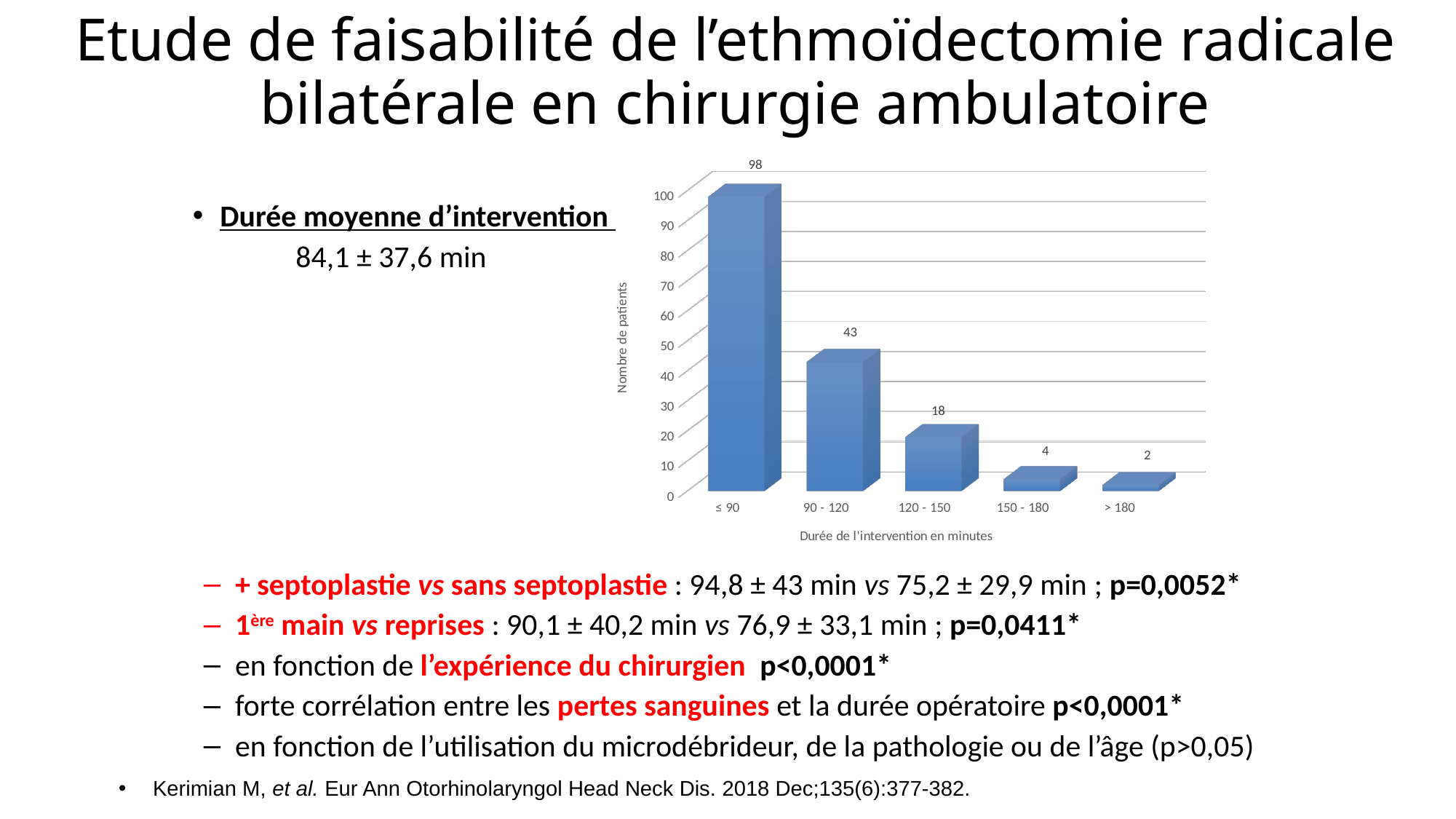
Do the number of patients rise or fall as the intervention duration increases along the x axis? Fall What type of chart is shown on the slide? Bar chart How many duration categories are shown on the x axis? 5 How many patients are in the 90 - 120 minute category? 43 How many patients had an intervention lasting more than 180 minutes? 2 Which duration category has the highest number of patients? ≤ 90 What is the number of patients for the 120 - 150 minute category? 18 What is the difference in number of patients between the ≤ 90 and 90 - 120 categories? 55 Which duration category has the lowest number of patients? > 180 What is the label of the vertical axis of the chart? Nombre de patients How many patients had an intervention duration of ≤ 90 minutes? 98 Which category has more patients, 120 - 150 or 150 - 180? 120 - 150